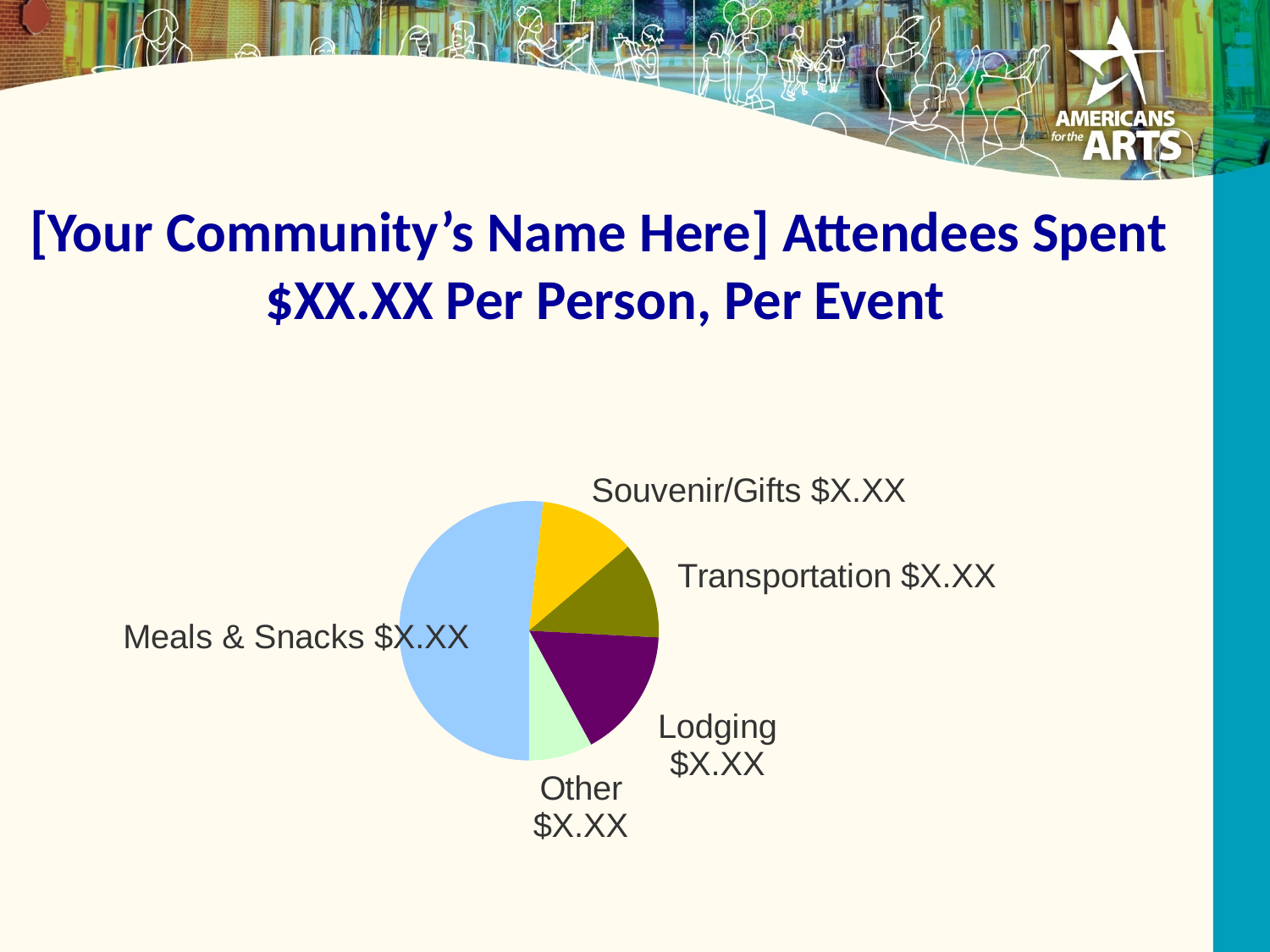
Which category has the smallest slice of the pie chart? Other How many slices does the pie chart have? 5 What colour is the Meals & Snacks slice? light blue Which category has the largest slice of the pie chart? Meals & Snacks Which slice is larger, Lodging or Other? Lodging Which slice is larger, Meals & Snacks or Transportation? Meals & Snacks What colour is the Lodging slice? purple Which slice is larger, Meals & Snacks or Lodging? Meals & Snacks What kind of chart is shown on the slide? pie chart What value label is shown for the Lodging slice? $X.XX